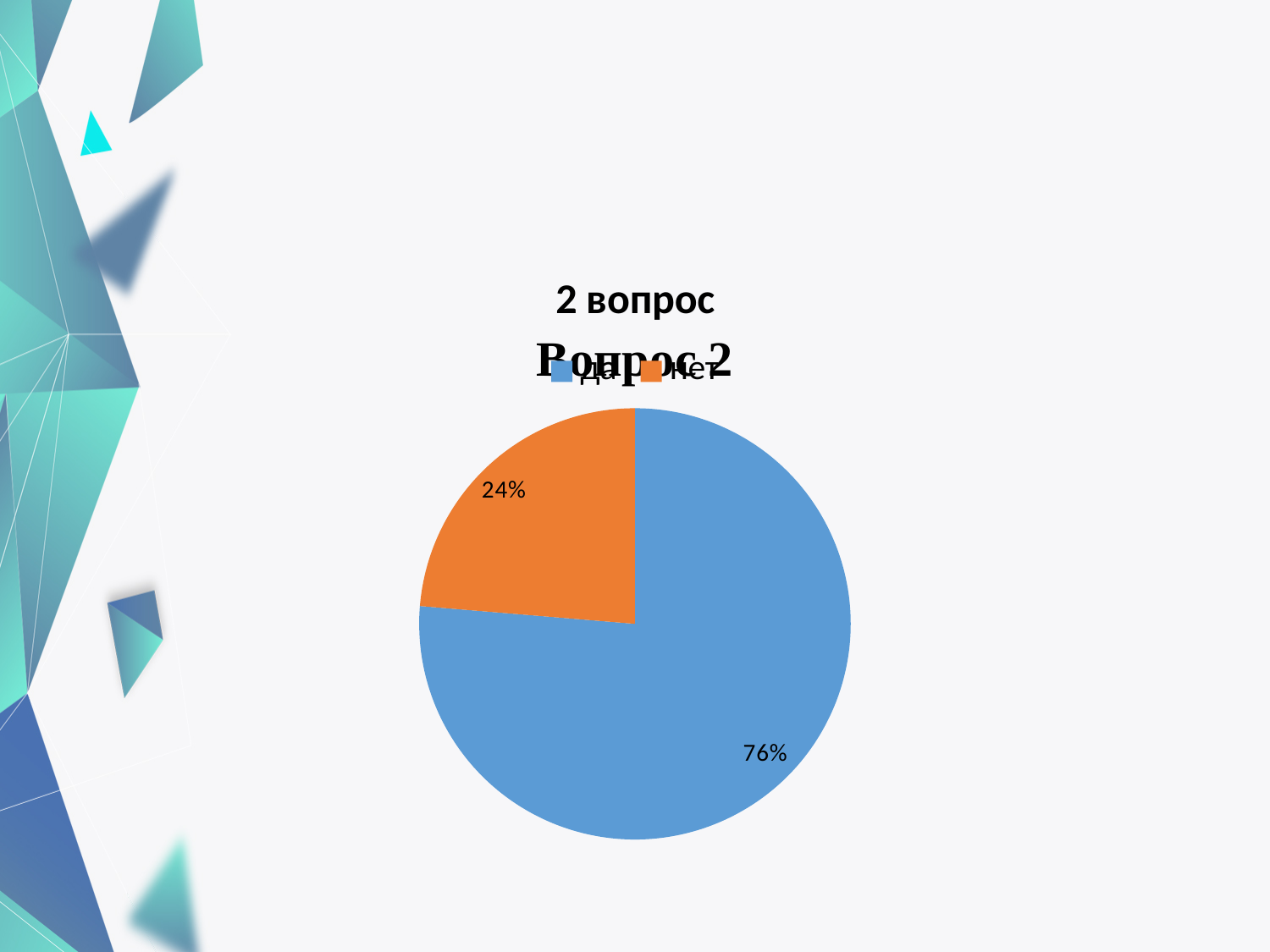
Which category has the largest share of the pie? да What percentage does the orange slice (нет) show? 24% What is the difference in percentage points between the да slice and the нет slice? 52 What is the title of the chart? 2 вопрос Which slice is larger, да or нет? да What share of the pie does the да slice represent? 76% What colour is the slice for нет? orange How many entries does the legend list? 2 Which category has the smallest share of the pie? нет What percentage does the blue slice (да) show? 76% What kind of chart is shown on the slide? pie chart How many slices does the pie chart have? 2